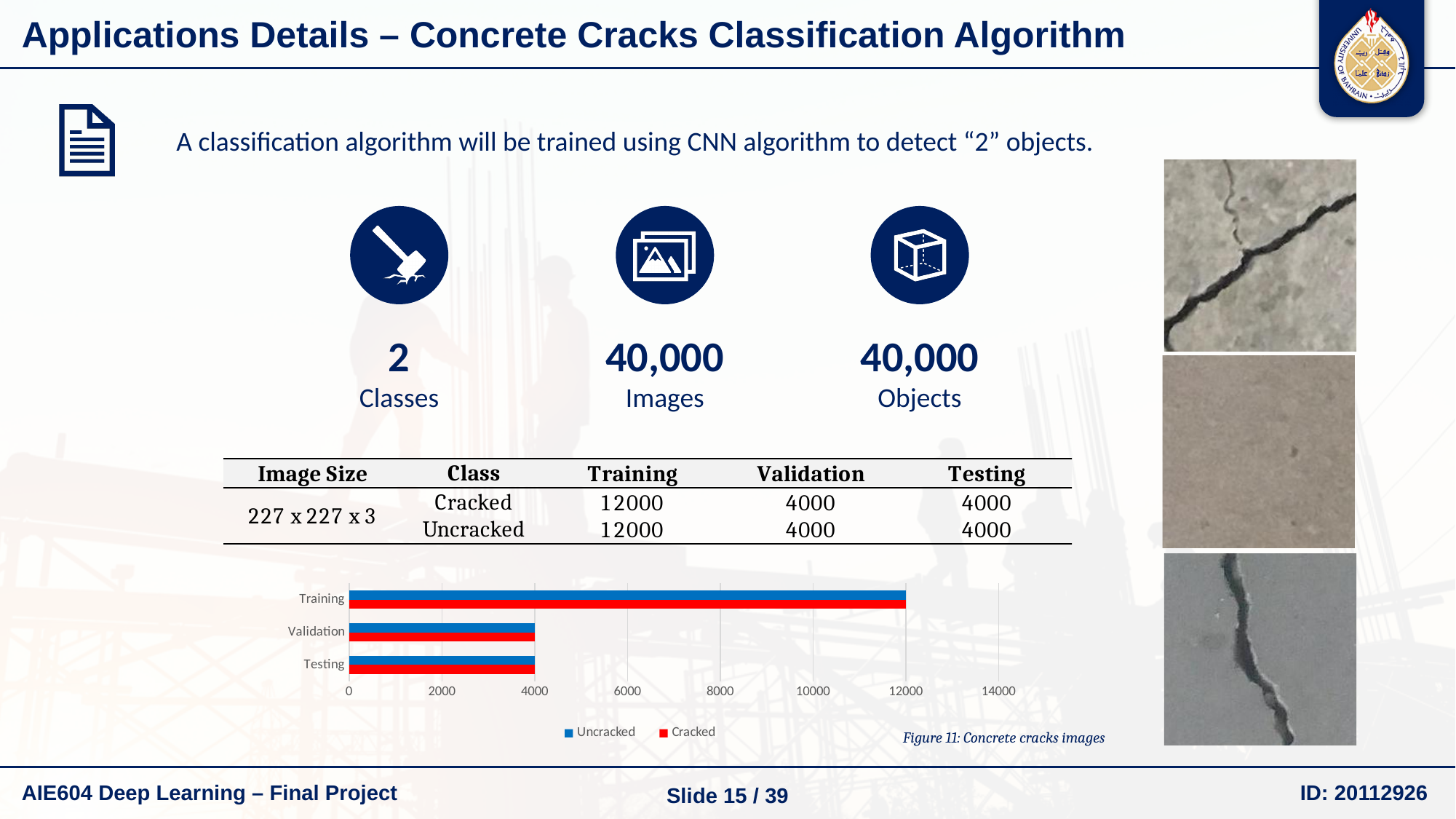
What is the difference between the Cracked value for Training and the Cracked value for Validation? 8000 Which category has the highest Cracked value? Training What is the value of the Uncracked bar for Training? 12000 Is the Cracked value for Validation greater or less than 6000? less Which is larger, the Uncracked value for Training or the Uncracked value for Testing? Training How many series does the chart's legend list? 2 How many categories are shown on the chart's vertical axis? 3 What is the value of the Cracked bar for Testing? 4000 Is the Uncracked value for Training greater or less than 10000? greater What is the value of the Cracked bar for Validation? 4000 Which series are listed in the chart's legend? Uncracked and Cracked What kind of chart is shown on the slide? bar chart